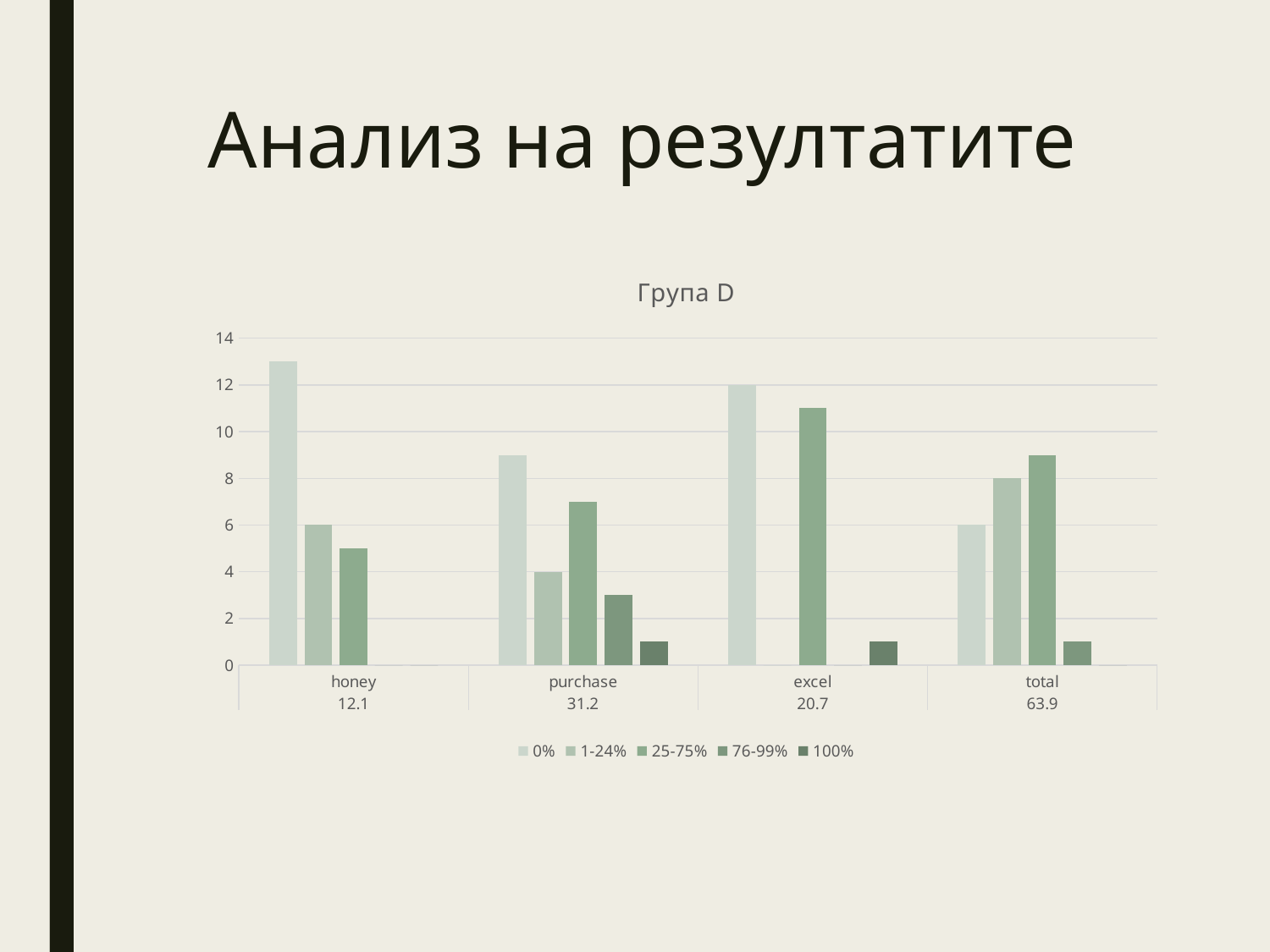
What type of chart is shown on the slide? bar chart Is the value of the 0% series for honey greater or less than 12? greater What is the value of the 25-75% series for honey? 5 Which is larger for excel: the 0% series or the 25-75% series? 0% What is the value of the 0% series for excel? 12 Is the value of the 25-75% series for purchase greater or less than 6? greater Which category has the highest value for the 0% series? honey What is the title of the chart? Група D How many categories are shown on the x axis? 4 What is the value of the 1-24% series for total? 8 What is the value of the 1-24% series for purchase? 4 How many series does the legend list? 5